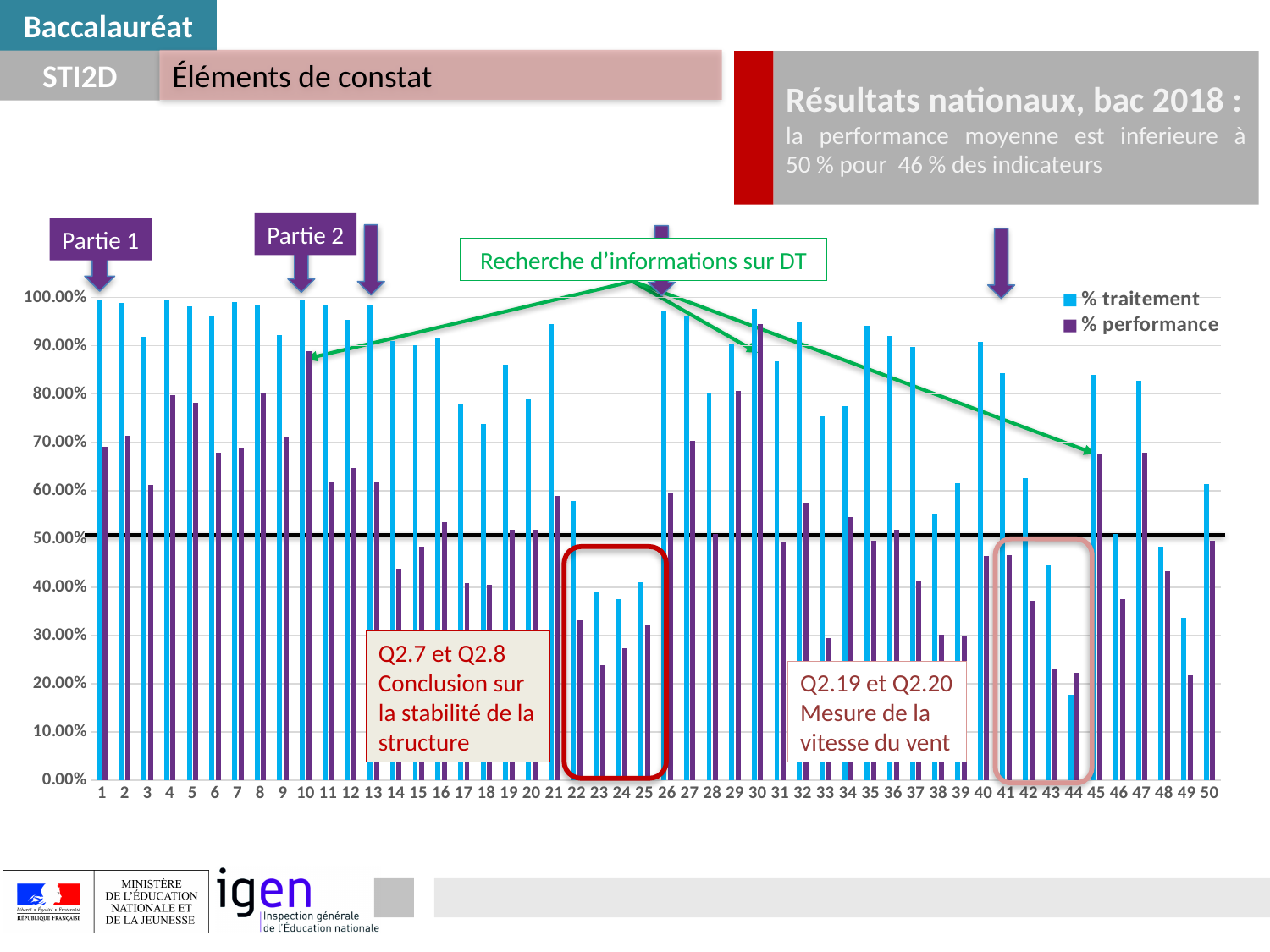
Is the % traitement value for category 22 greater or less than 50.00%? greater How many categories are plotted along the x axis of the chart? 50 Which colour represents the % traitement series in the chart? blue What kind of chart is shown on the slide? bar chart How many series does the chart legend list? 2 For category 1, which is larger: % traitement or % performance? % traitement Is the % traitement value for category 44 greater or less than 20.00%? less Is the % performance value for category 30 greater or less than 90.00%? greater Which category has the lowest % traitement value? 44 What are the two series named in the chart legend? % traitement and % performance